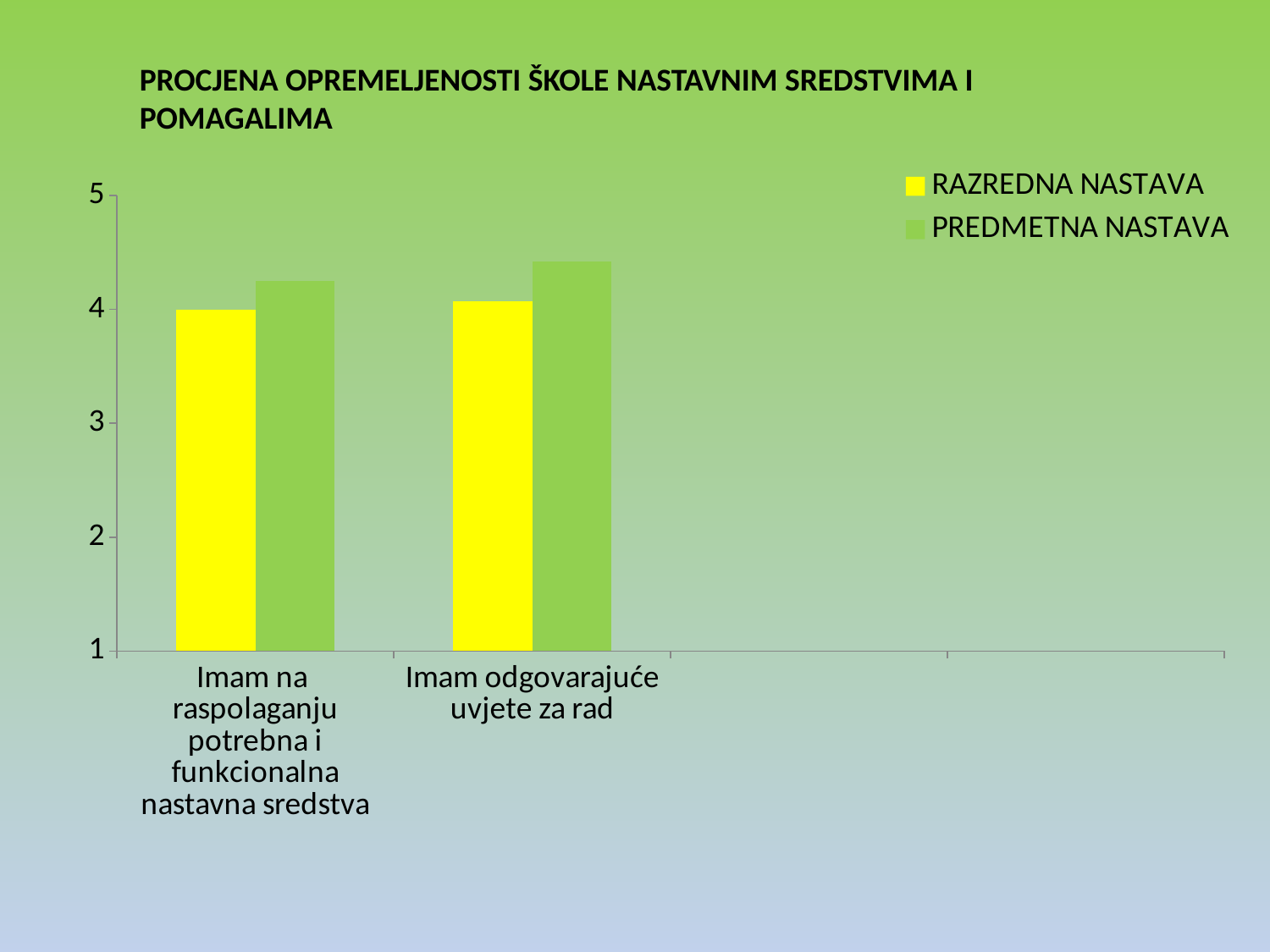
Which category has the highest PREDMETNA NASTAVA value? Imam odgovarajuće uvjete za rad How many series does the legend list? 2 Is the PREDMETNA NASTAVA value for "Imam na raspolaganju potrebna i funkcionalna nastavna sredstva" greater or less than 4? greater How many categories are shown on the x axis of the chart? 2 Is the RAZREDNA NASTAVA value for "Imam odgovarajuće uvjete za rad" greater or less than 5? less Which series is shown in yellow in the chart? RAZREDNA NASTAVA What kind of chart is shown on the slide? bar chart For "Imam na raspolaganju potrebna i funkcionalna nastavna sredstva", which series has the larger value, RAZREDNA NASTAVA or PREDMETNA NASTAVA? PREDMETNA NASTAVA Is the PREDMETNA NASTAVA value for "Imam odgovarajuće uvjete za rad" greater or less than 4? greater For "Imam odgovarajuće uvjete za rad", which series has the larger value, RAZREDNA NASTAVA or PREDMETNA NASTAVA? PREDMETNA NASTAVA What is the title of the chart? PROCJENA OPREMELJENOSTI ŠKOLE NASTAVNIM SREDSTVIMA I POMAGALIMA